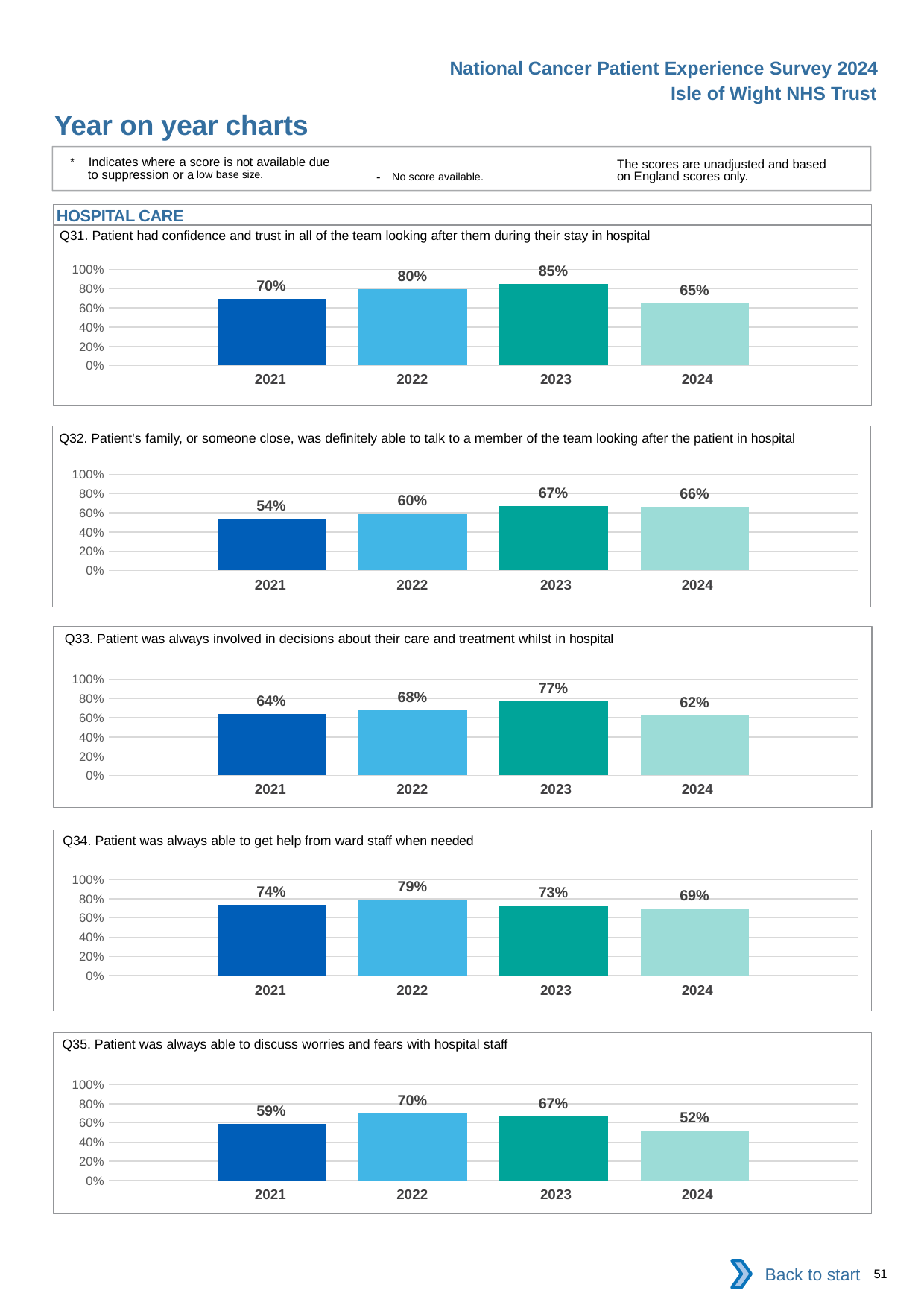
In the Q35 chart, what is the value for 2024? 52% In the Q34 chart, what is the difference between the 2022 and 2024 values? 10 percentage points In the Q35 chart, which year has the highest value? 2022 In the Q33 chart, what is the value for 2024? 62% What kind of chart is the Q34 chart? bar chart In the Q32 chart, what is the value for 2021? 54% In the Q31 chart, what is the value for 2023? 85% In the Q32 chart, what is the difference between the 2023 and 2021 values? 13 percentage points In the Q33 chart, which year has the highest value? 2023 In the Q31 chart, which year has the lowest value? 2024 How many years are shown on the x axis of the Q31 chart? 4 In the Q34 chart, is the value for 2022 larger or smaller than the value for 2023? larger